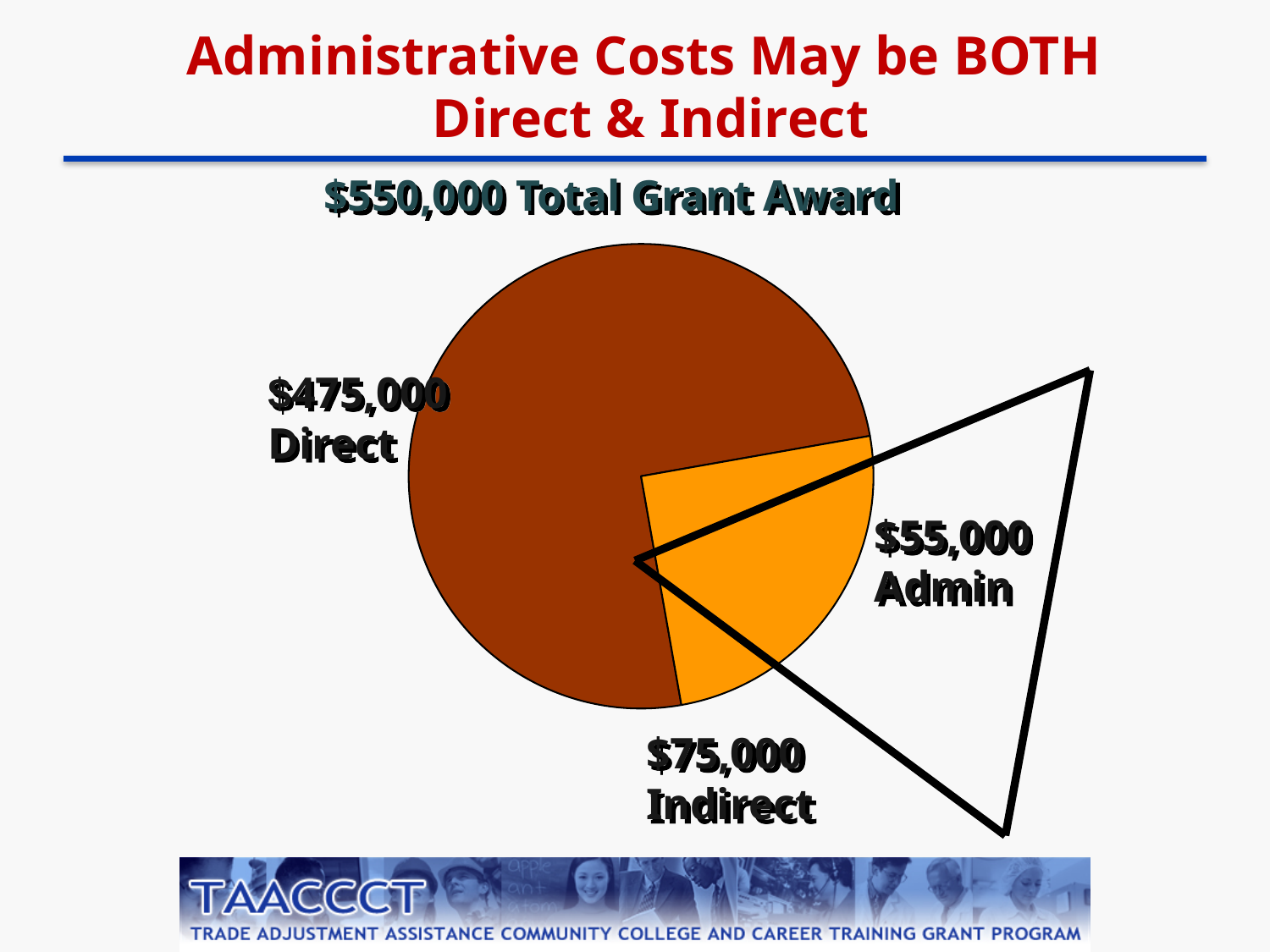
What colour is the Indirect slice of the pie chart? Orange Which is larger in the pie chart, Direct or Indirect? Direct Which slice of the pie chart is the largest? Direct What is the difference between the Direct and Indirect amounts in the pie chart? $400,000 Which slice of the pie chart is the smallest? Indirect What amount is labelled as Admin in the callout pointing at the pie chart? $55,000 What is the value of the Direct slice of the pie chart? $475,000 What is the title shown above the pie chart? $550,000 Total Grant Award What is the total grant award shown above the pie chart? $550,000 How many slices does the pie chart have? 2 What is the value of the Indirect slice of the pie chart? $75,000 What kind of chart is shown on the slide? Pie chart